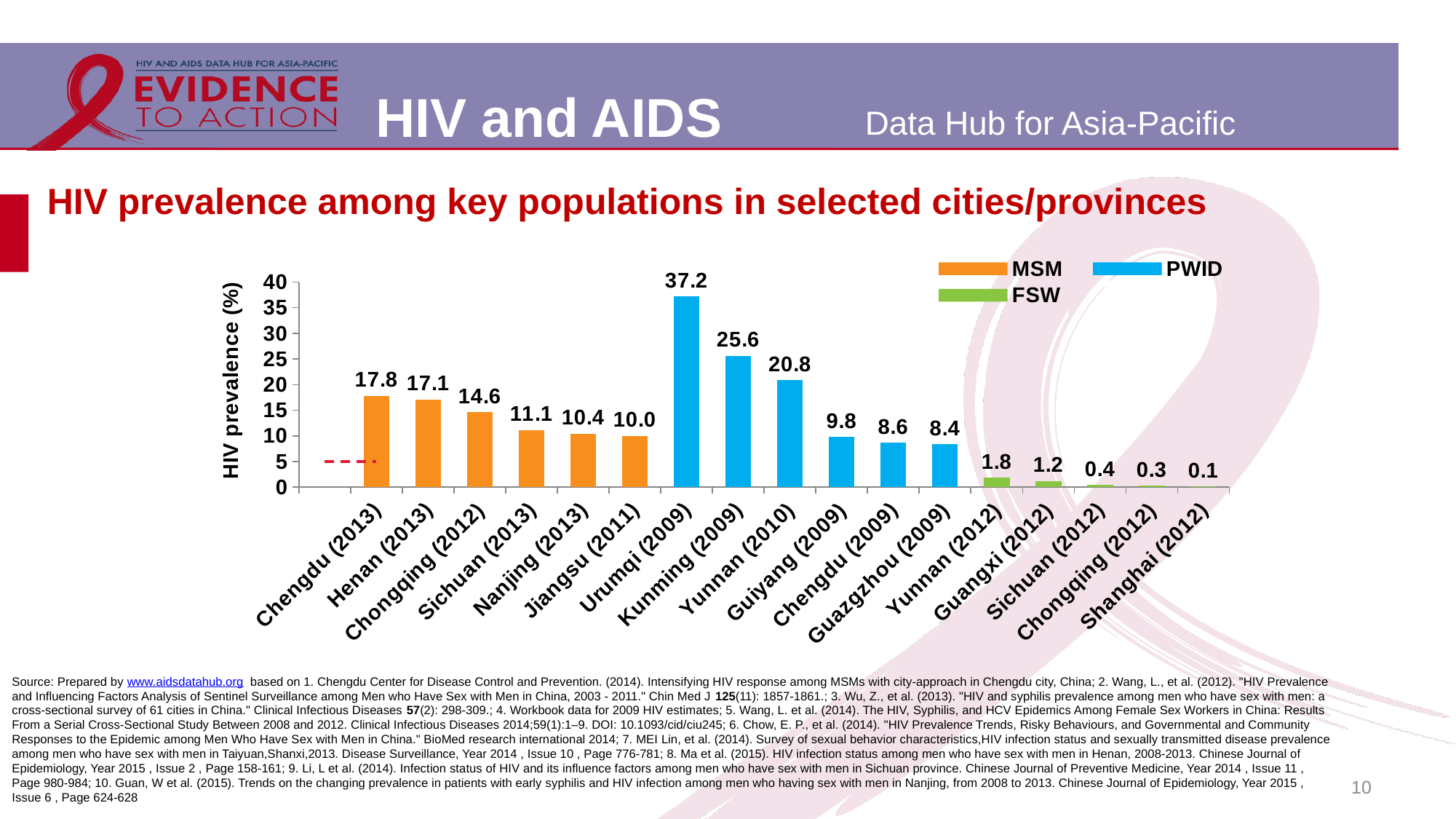
Which city/province has the lowest HIV prevalence on the chart? Shanghai (2012) What is the label of the vertical axis? HIV prevalence (%) Which key population is represented by the blue bars? PWID What is the difference in HIV prevalence between Kunming (2009) and Yunnan (2010)? 4.8 What is the HIV prevalence for Urumqi (2009)? 37.2 How many cities/provinces are plotted on the chart? 17 Which has a higher HIV prevalence, Chengdu (2013) or Chongqing (2012)? Chengdu (2013) What is the HIV prevalence for Guangxi (2012)? 1.2 What is the HIV prevalence for Henan (2013)? 17.1 How many series does the legend list? 3 What kind of chart is shown on the slide? Bar chart Which city/province has the highest HIV prevalence on the chart? Urumqi (2009)